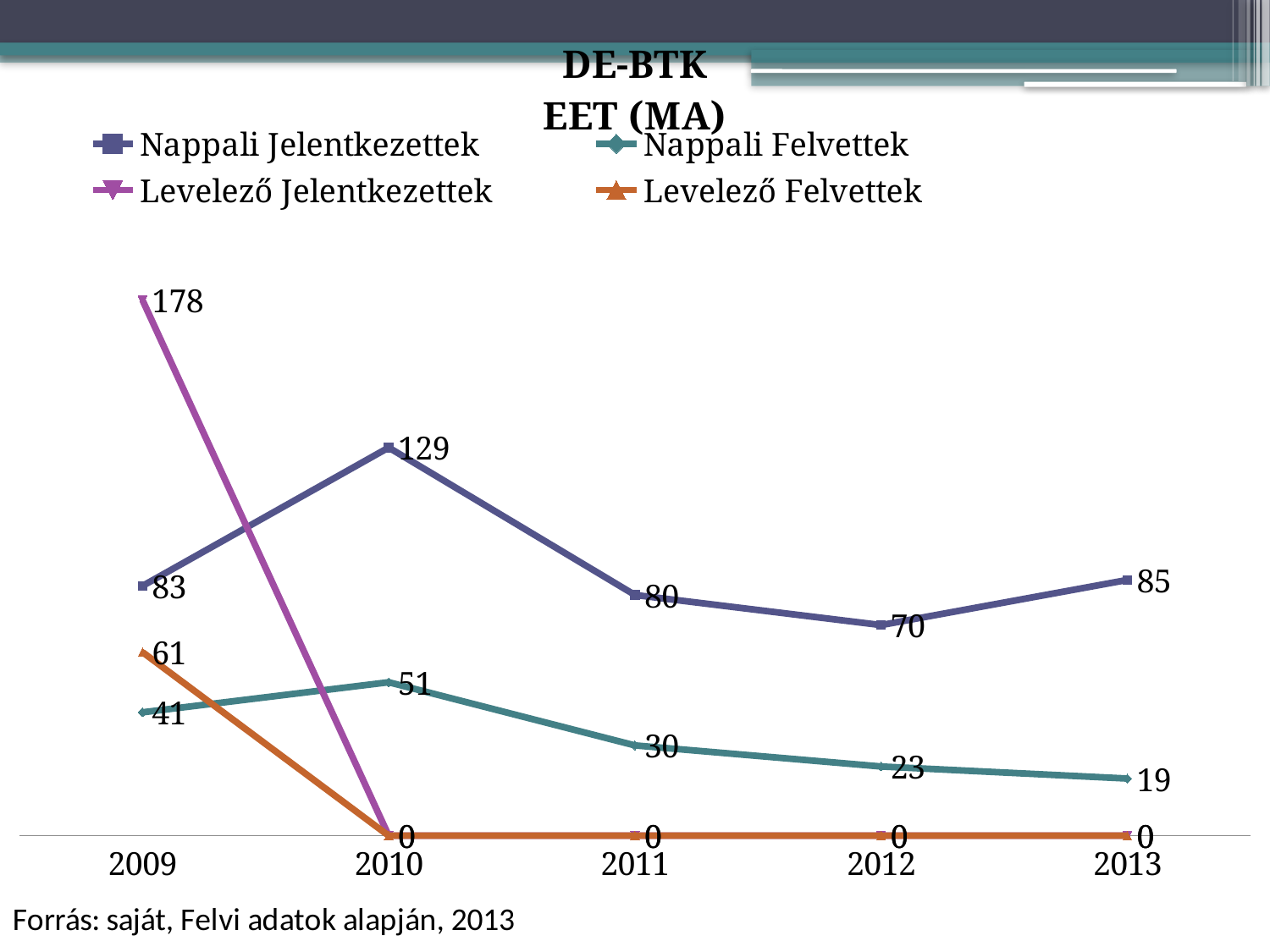
How many years are shown on the x axis? 5 What is the value for Nappali Felvettek in 2013? 19 What is the difference between Nappali Jelentkezettek and Nappali Felvettek in 2011? 50 Which is larger in 2009: Nappali Jelentkezettek or Levelező Felvettek? Nappali Jelentkezettek Does Nappali Felvettek rise or fall from 2010 to 2013? fall What is the value for Levelező Jelentkezettek in 2009? 178 How many series does the legend list? 4 In which year is Nappali Jelentkezettek highest? 2010 What type of chart is shown on the slide? line chart What is the value for Levelező Felvettek in 2009? 61 What is the value for Nappali Jelentkezettek in 2010? 129 In which year is Nappali Felvettek lowest? 2013